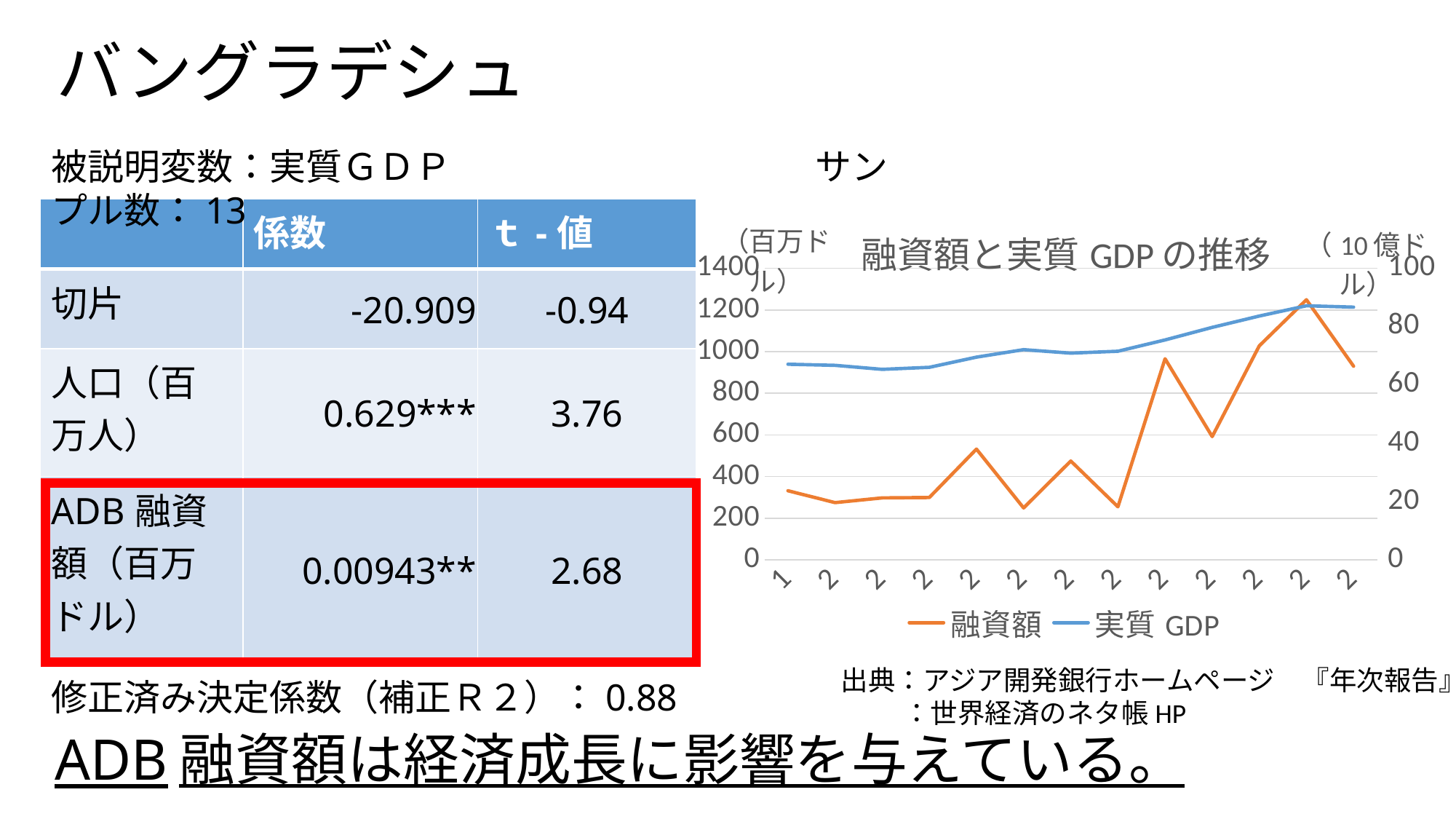
Is the value of 実質 GDP at the last point greater or less than 80 on the right axis? greater Is the value of 実質 GDP at the first point greater or less than 60 on the right axis? greater How many data points are plotted along the x axis of the chart? 13 What are the two series named in the chart legend? 融資額 and 実質 GDP How many series does the chart legend list? 2 Does the 実質 GDP line generally rise or fall from left to right? rise Is the value of 融資額 at the last point greater or less than 1000 on the left axis? less At which point along the x axis does the 融資額 line reach its peak? the second-to-last (12th) point What is the title of the chart? 融資額と実質 GDP の推移 What kind of chart is shown on the slide? line chart